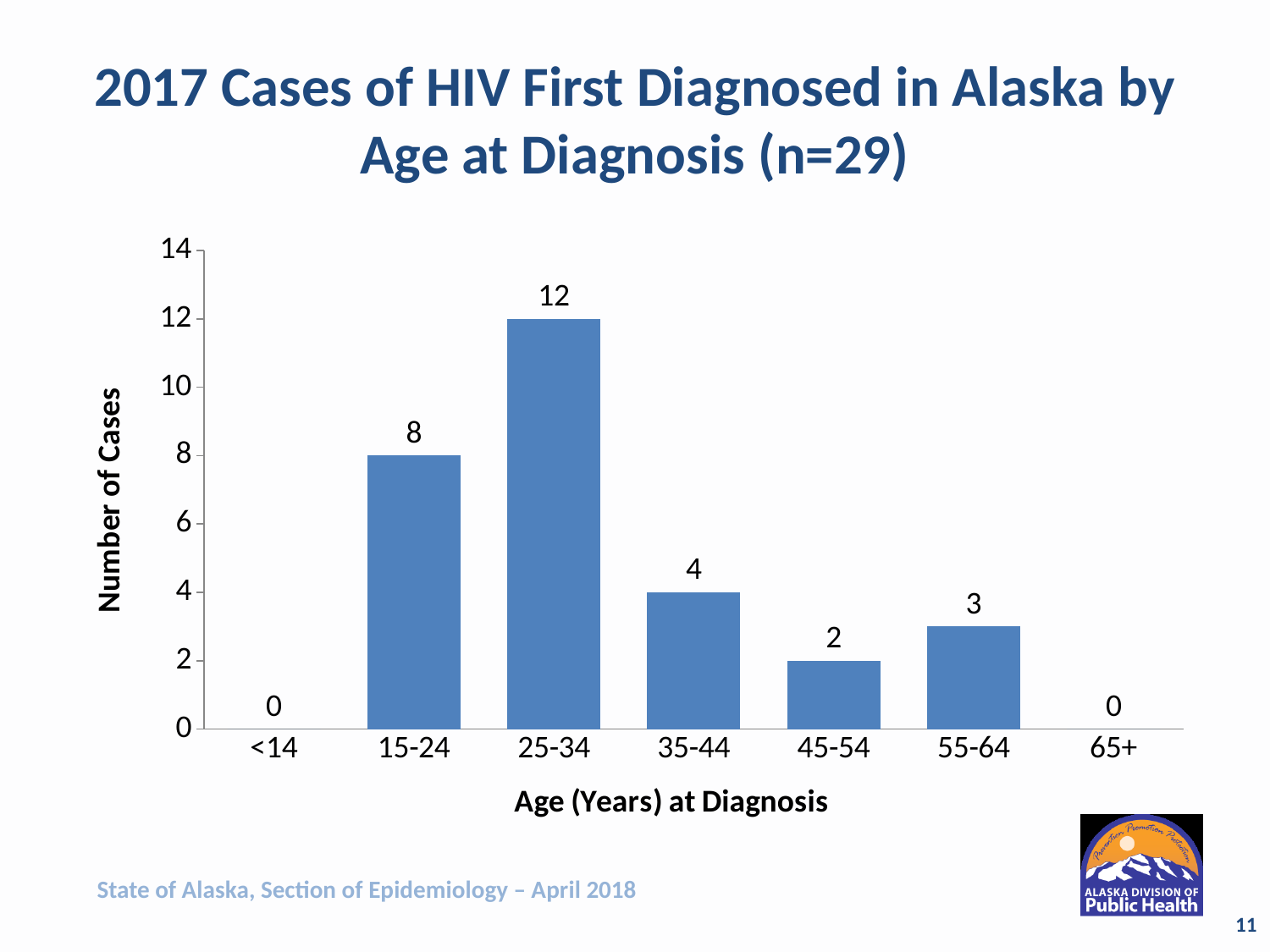
How many cases are shown for the 45-54 age group? 2 How many age groups are shown on the x axis? 7 How many HIV cases were first diagnosed in the 25-34 age group? 12 What is the label of the y axis? Number of Cases What is the number of cases for the 15-24 age group? 8 What is the total number of cases across the 35-44, 45-54 and 55-64 age groups? 9 What is the difference in number of cases between the 25-34 and 15-24 age groups? 4 Is the value for the 25-34 age group greater or less than 10? greater Which age group has the highest number of cases? 25-34 Which age group has more cases, 35-44 or 55-64? 35-44 Which age groups have zero cases? <14 and 65+ What type of chart is shown on the slide? Bar chart